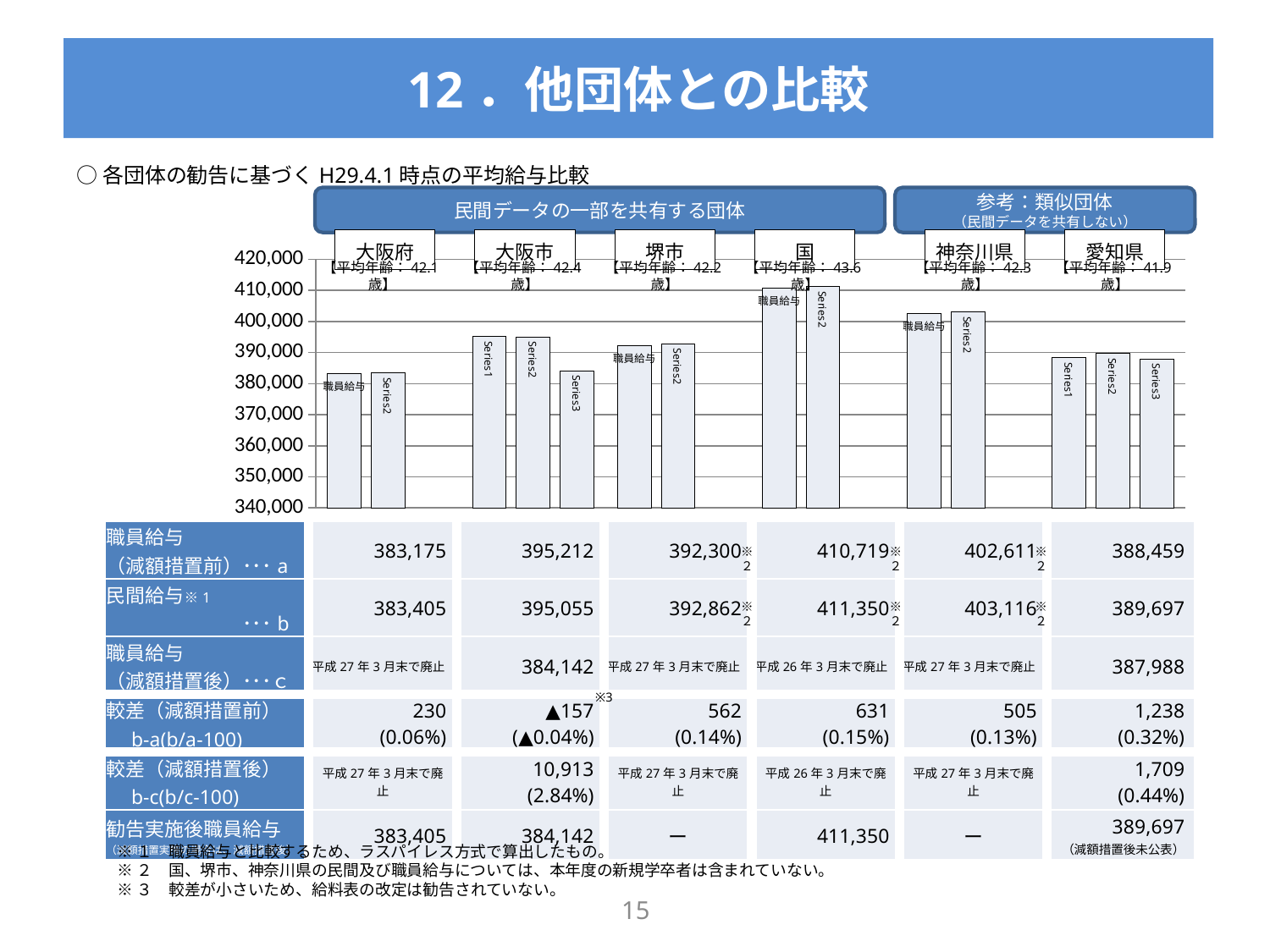
Which has taller bars in the chart, 国 or 愛知県? 国 What kind of chart is shown on the slide? bar chart Which two organizations are grouped under the heading 参考：類似団体 in the chart? 神奈川県 and 愛知県 According to the table under the chart, what is the 勧告実施後職員給与 value for 国? 411,350 According to the table under the chart, what is the 職員給与（減額措置前） value for 大阪府? 383,175 How many organizations (categories) are shown along the x axis of the chart? 6 Is the Series1 bar for 愛知県 greater or less than 380,000? greater How many bars are plotted for 愛知県? 3 Is the Series2 bar for 国 greater or less than 400,000? greater Is the 職員給与 bar for 大阪府 greater or less than 390,000? less Which organization has the highest bars in the chart? 国 According to the table under the chart, what is the 民間給与 value for 愛知県? 389,697